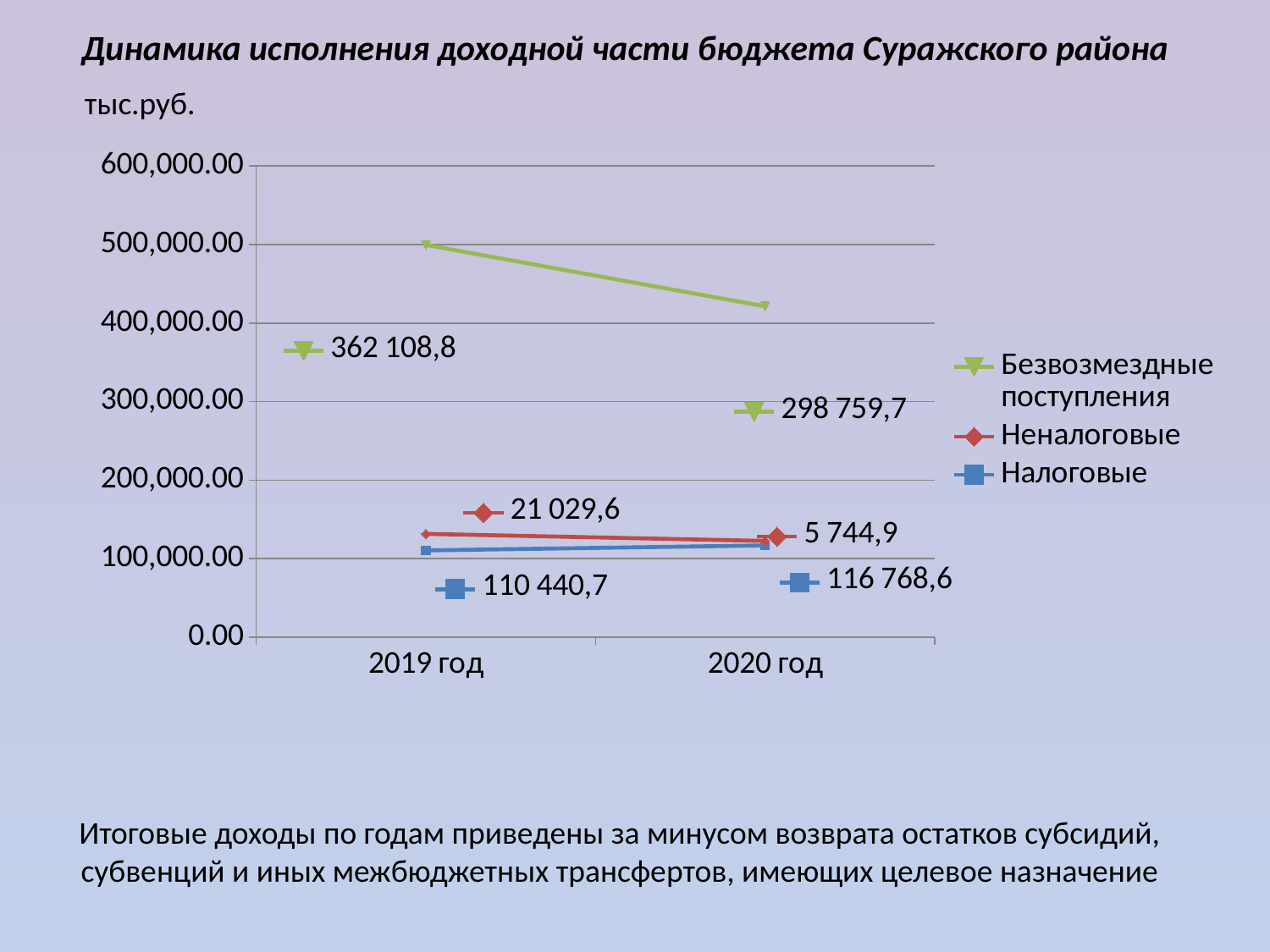
What is the value for Неналоговые in 2020 год? 5 744,9 What is the value for Налоговые in 2020 год? 116 768,6 How many series does the legend list? 3 Which series has the highest value in 2019 год? Безвозмездные поступления What is the value for Безвозмездные поступления in 2020 год? 298 759,7 What kind of chart is shown on the slide? line chart What is the value for Безвозмездные поступления in 2019 год? 362 108,8 By how much did Безвозмездные поступления decrease from 2019 год to 2020 год? 63 349,1 Does the Налоговые series rise or fall from 2019 год to 2020 год? rise By how much did Налоговые increase from 2019 год to 2020 год? 6 327,9 What is the value for Налоговые in 2019 год? 110 440,7 What is the value for Неналоговые in 2019 год? 21 029,6